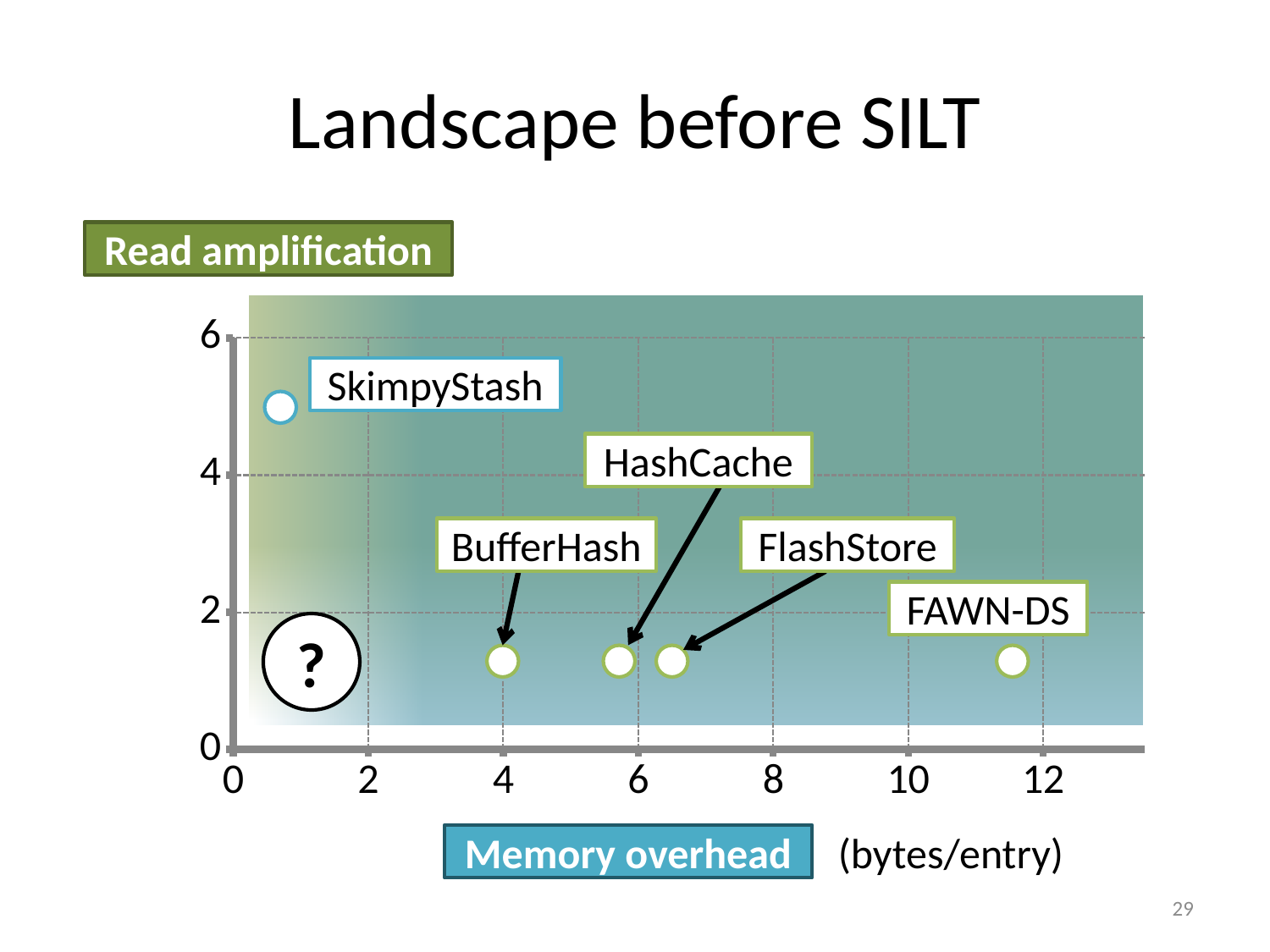
How many named systems are plotted on the chart? 5 Which has the larger memory overhead, BufferHash or FlashStore? FlashStore Is the read amplification for SkimpyStash greater or less than 4? greater Is the memory overhead for FAWN-DS greater or less than 10? greater Which system has the lowest memory overhead? SkimpyStash Which system has the highest memory overhead? FAWN-DS What is the title of the chart? Landscape before SILT What kind of chart is shown on the slide? scatter plot What unit is given for the memory overhead axis? bytes/entry Is the memory overhead for BufferHash greater or less than 6? less Which system has the highest read amplification? SkimpyStash